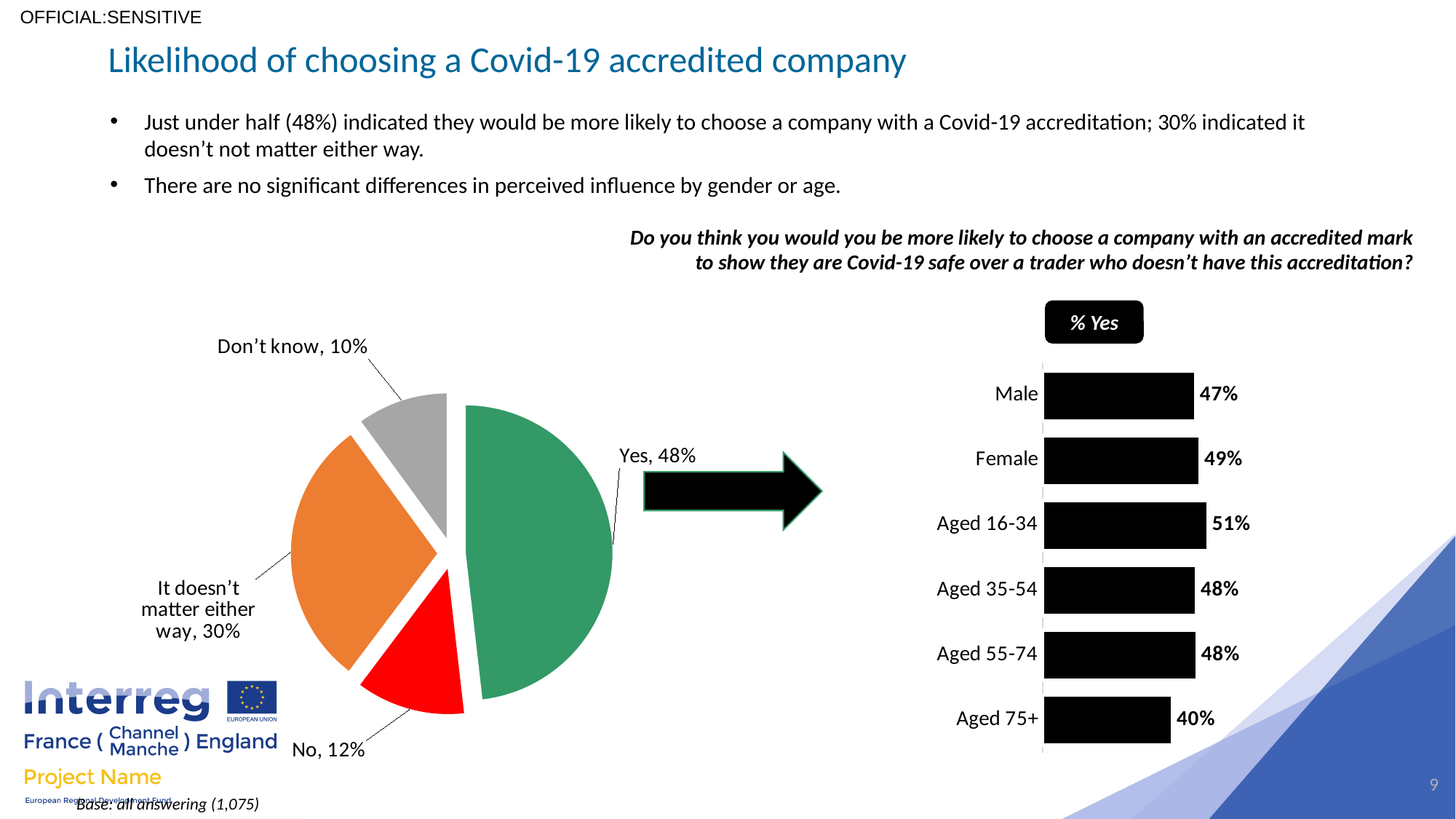
In the '% Yes' bar chart on the right, what is the value for Aged 75+? 40% In the pie chart on the left, what is the difference between the 'Yes' share and the 'It doesn't matter either way' share? 18 percentage points In the pie chart on the left, how many slices are there? 4 In the '% Yes' bar chart on the right, which is larger, Male or Female? Female In the '% Yes' bar chart on the right, which group has the highest value? Aged 16-34 What type of chart is shown on the left of the slide? Pie chart In the pie chart on the left, what percentage answered 'No'? 12% In the pie chart on the left, what percentage answered 'Yes'? 48% In the '% Yes' bar chart on the right, how many groups are shown? 6 In the '% Yes' bar chart on the right, what is the value for Female? 49% In the pie chart on the left, which response has the smallest share? Don't know In the pie chart on the left, which response has the largest share? Yes